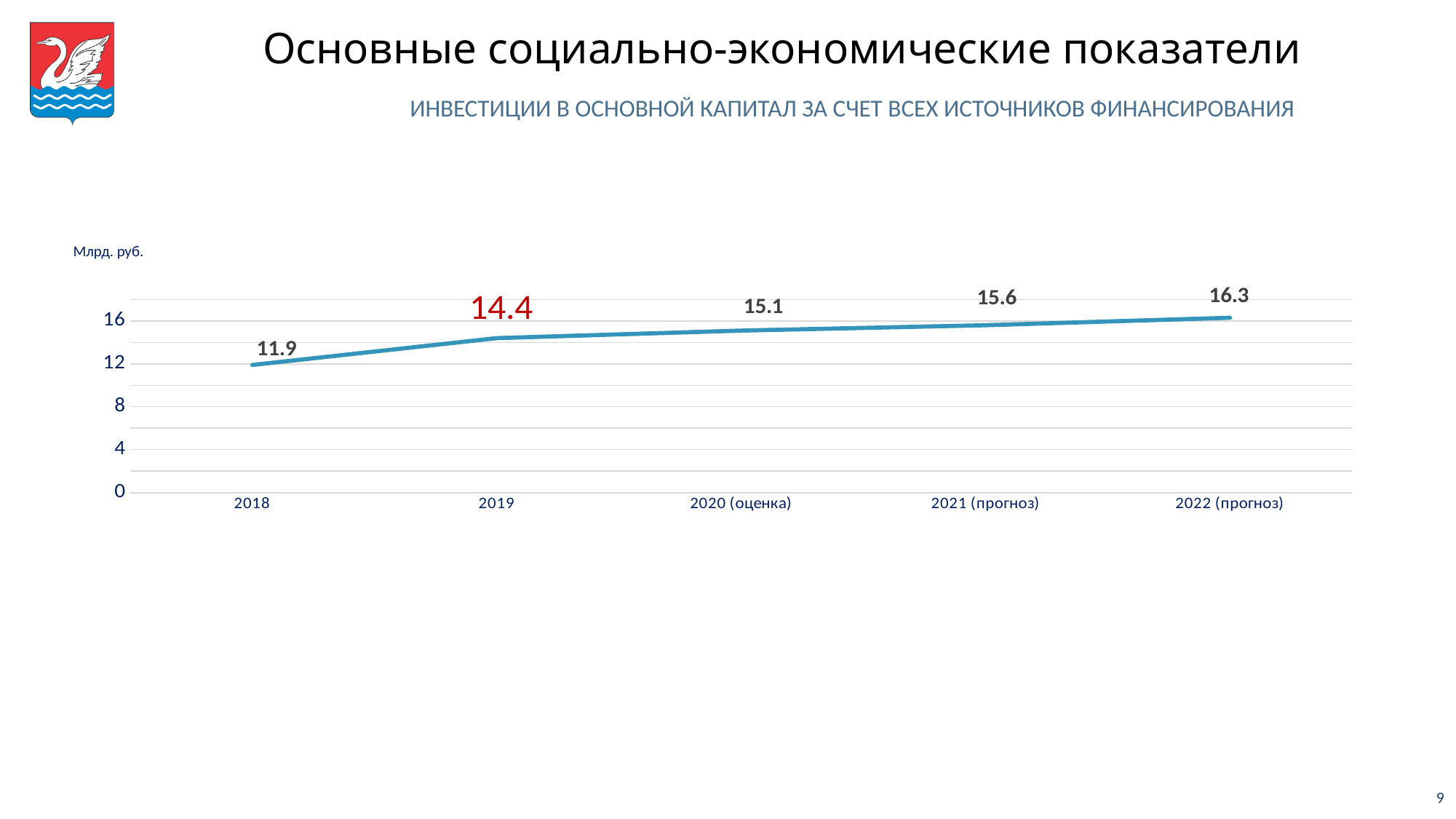
What is the value for 2020 (оценка)? 15.1 Do the values rise or fall from 2018 to 2022 (прогноз)? rise Which year has the lowest value? 2018 What is the difference between the values for 2022 (прогноз) and 2018? 4.4 What is the value for 2018? 11.9 What kind of chart is shown? line chart How many data points are plotted on the chart? 5 What unit is shown on the chart's axis label? Млрд. руб. Which is larger, the value for 2019 or the value for 2021 (прогноз)? 2021 (прогноз) What is the value for 2019? 14.4 What is the value for 2022 (прогноз)? 16.3 Which year has the highest value? 2022 (прогноз)